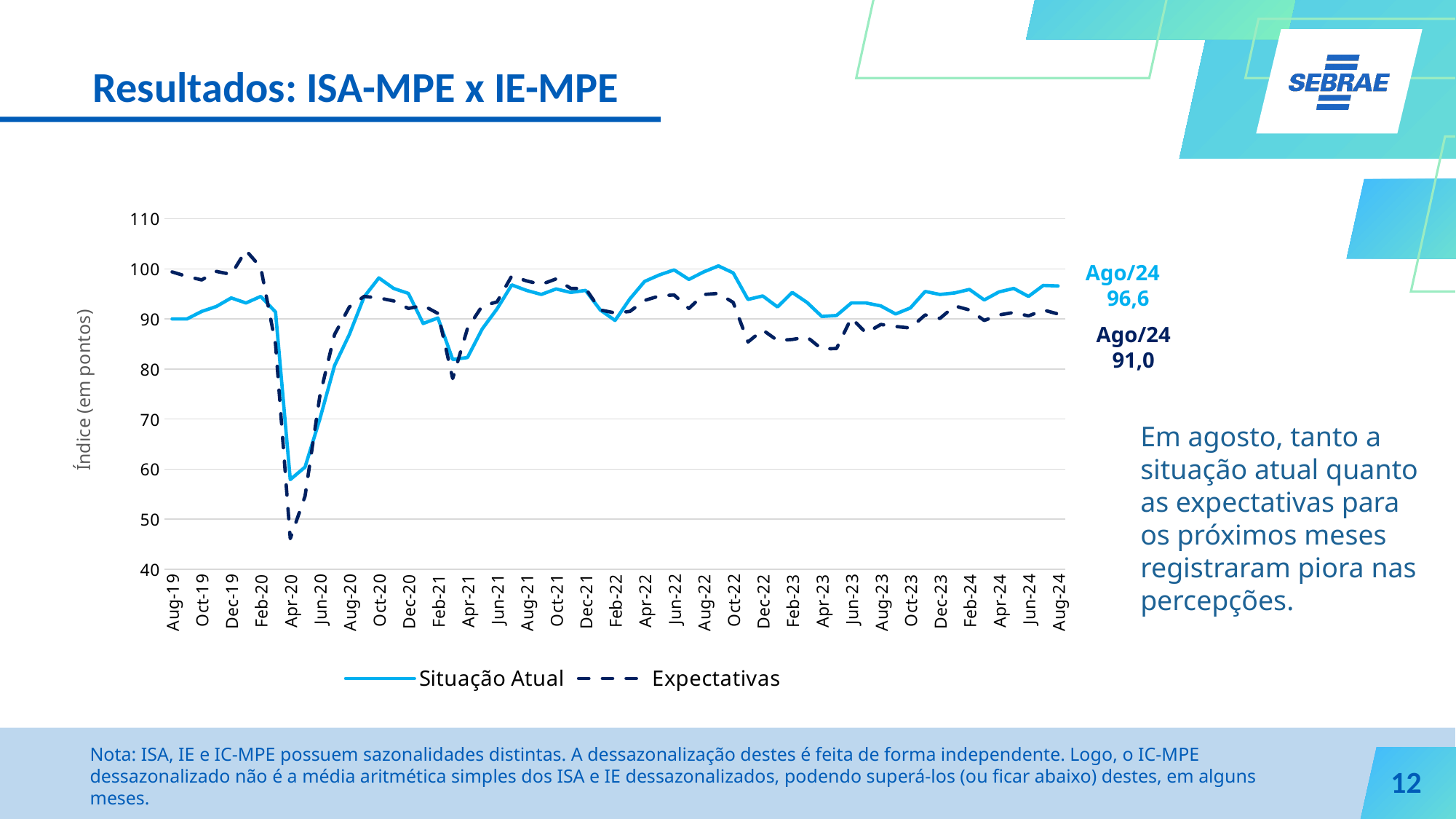
What is the value of Expectativas in Ago/24? 91,0 Is the value of Situação Atual in Apr-20 greater or less than 70? less In which month does Situação Atual reach its lowest value? Apr-20 What is the difference between Situação Atual and Expectativas in Ago/24? 5,6 How many series does the legend list? 2 What is the value of Situação Atual in Ago/24? 96,6 Is the value of Expectativas in Apr-20 greater or less than 60? less In Ago/24, which series has the higher value, Situação Atual or Expectativas? Situação Atual What is the label of the vertical axis? Índice (em pontos) Between Feb-20 and Apr-20, does Situação Atual rise or fall? fall What kind of chart is shown on the slide? Line chart Is the value of Situação Atual in Oct-20 greater or less than 90? greater